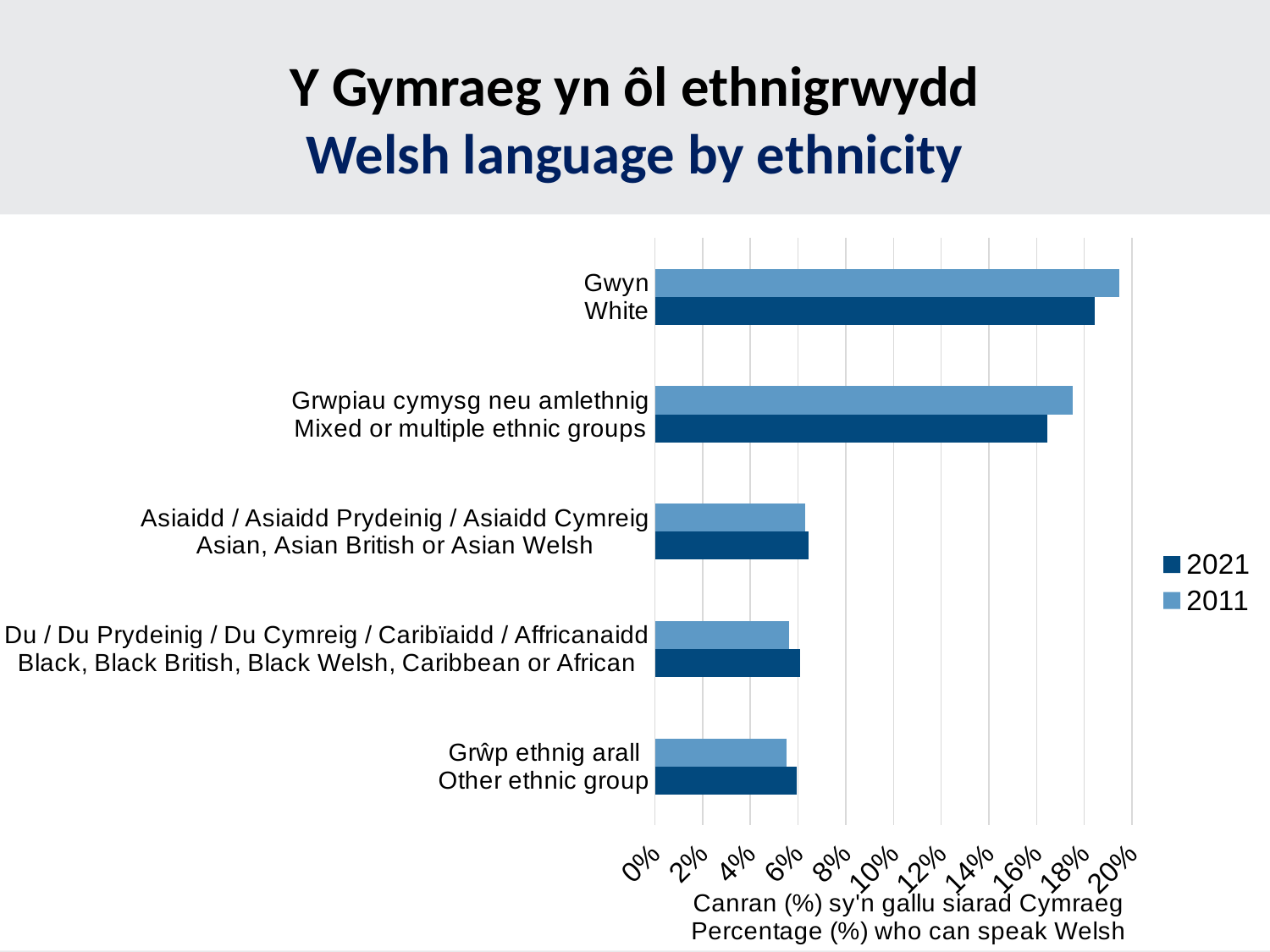
Which ethnic group has the highest percentage who can speak Welsh in 2011? White Is the 2011 value for White greater or less than 18%? greater What kind of chart is shown on the slide? Bar chart How many series does the legend list? 2 For White, which year has the larger percentage who can speak Welsh, 2011 or 2021? 2011 Is the 2021 value for Asian, Asian British or Asian Welsh greater or less than 8%? less What are the two years listed in the legend? 2021 and 2011 Is the 2021 value for Mixed or multiple ethnic groups greater or less than 14%? greater Which ethnic group has the highest percentage who can speak Welsh in 2021? White How many ethnic groups are shown on the chart? 5 Which has the larger 2021 value, White or Other ethnic group? White